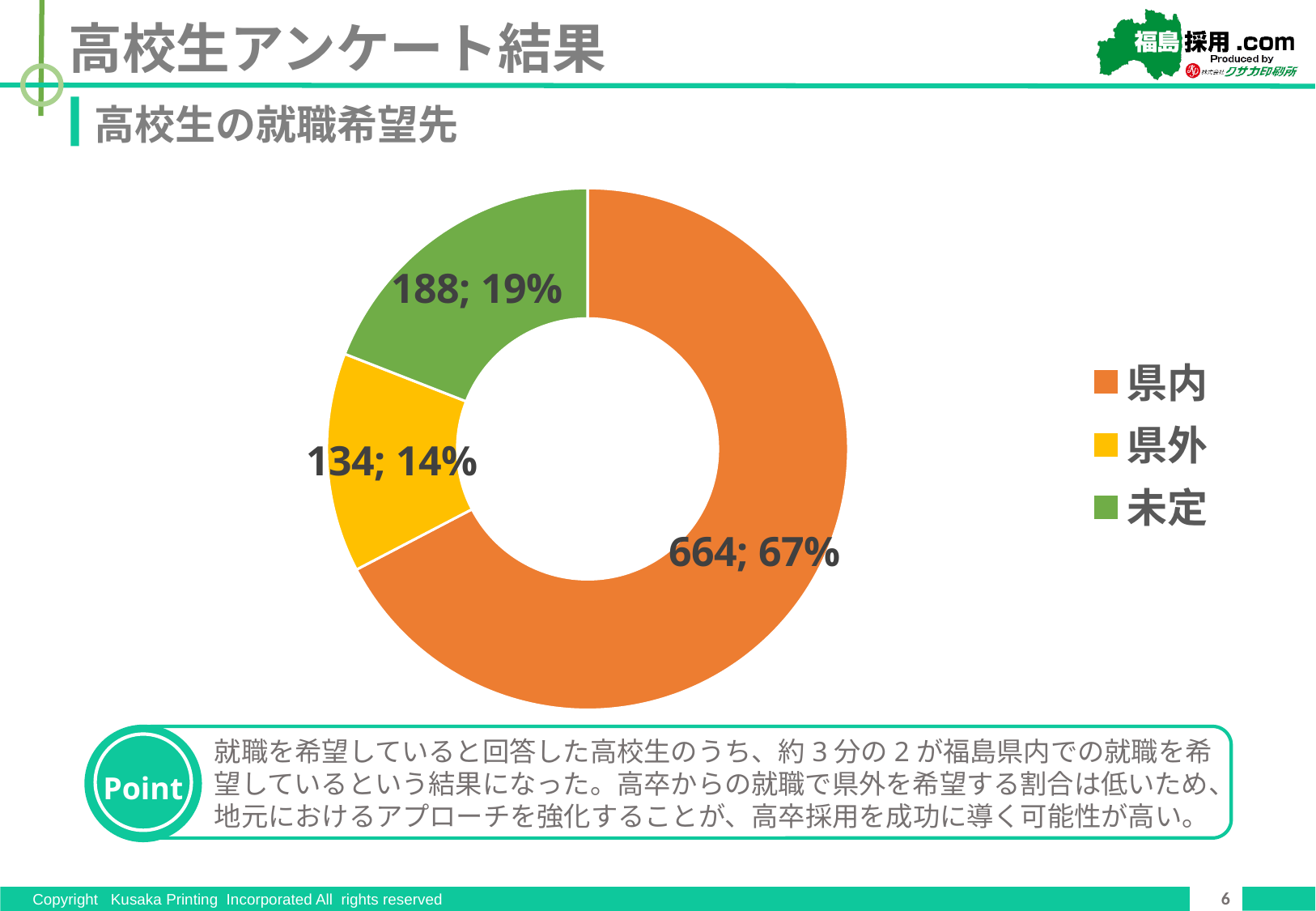
What share of the chart does 県内 represent? 67% What is the value for 県内? 664 What colour is the 県外 slice? Yellow Which category has the largest slice? 県内 What is the value for 県外? 134 What is the difference between the values for 県内 and 未定? 476 What kind of chart is shown on the slide? Doughnut (pie) chart Which is larger, the value for 未定 or the value for 県外? 未定 What is the value for 未定? 188 What share of the chart does 未定 represent? 19% Which category has the smallest slice? 県外 How many categories does the chart show? 3